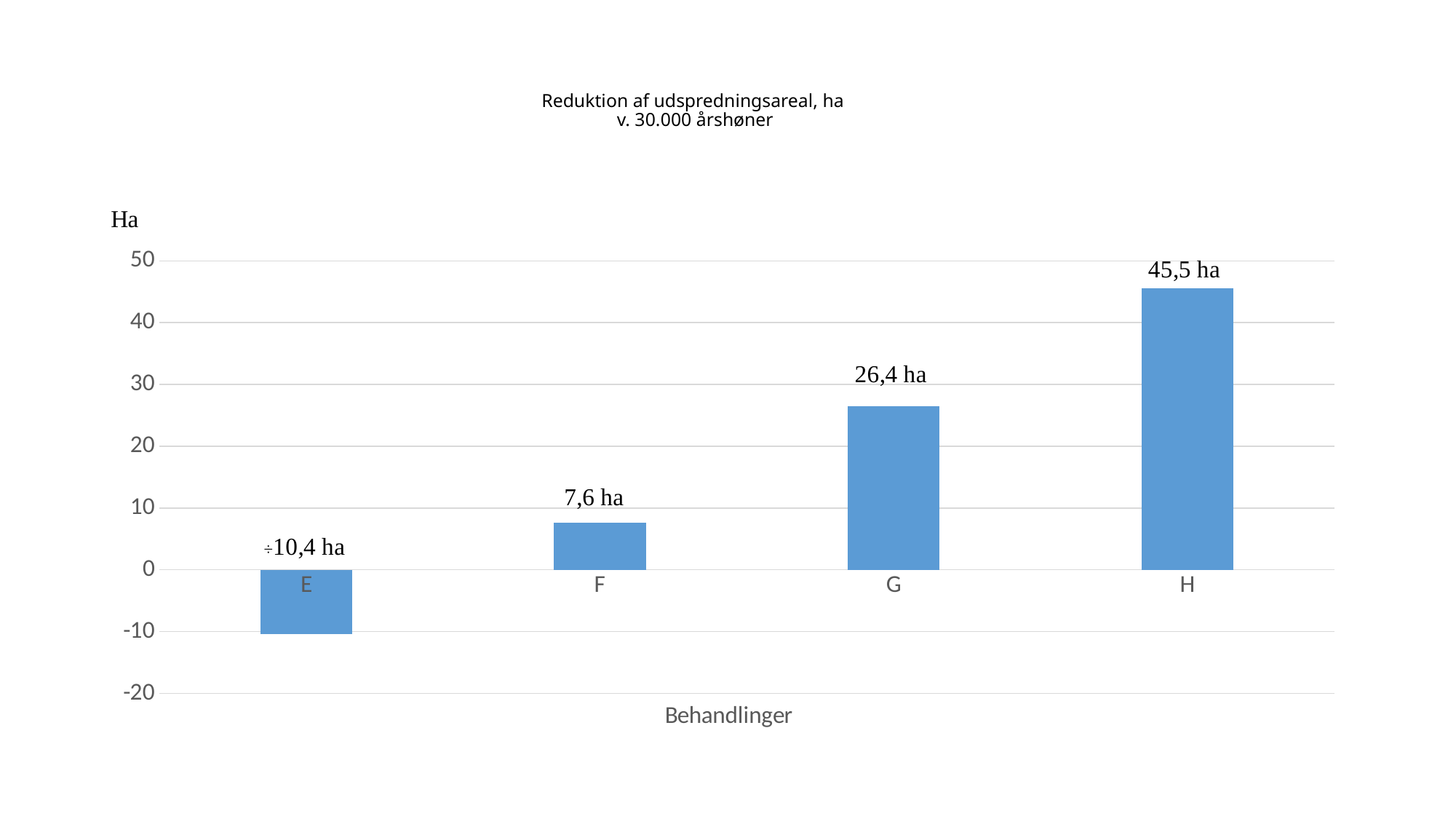
What is the value shown for treatment G? 26,4 ha What kind of chart is shown on the slide? Bar chart What is the value shown for treatment H? 45,5 ha What is the difference between the values for H and G? 19,1 ha What is the value shown for treatment E? ÷10,4 ha Which treatment has the highest reduction in spreading area? H How many treatments are shown on the x axis? 4 Which treatment has the lowest value on the chart? E What is the difference between the values for G and F? 18,8 ha Is the value for H greater or less than 40? greater Which is larger, the value for G or the value for F? G What is the value shown for treatment F? 7,6 ha